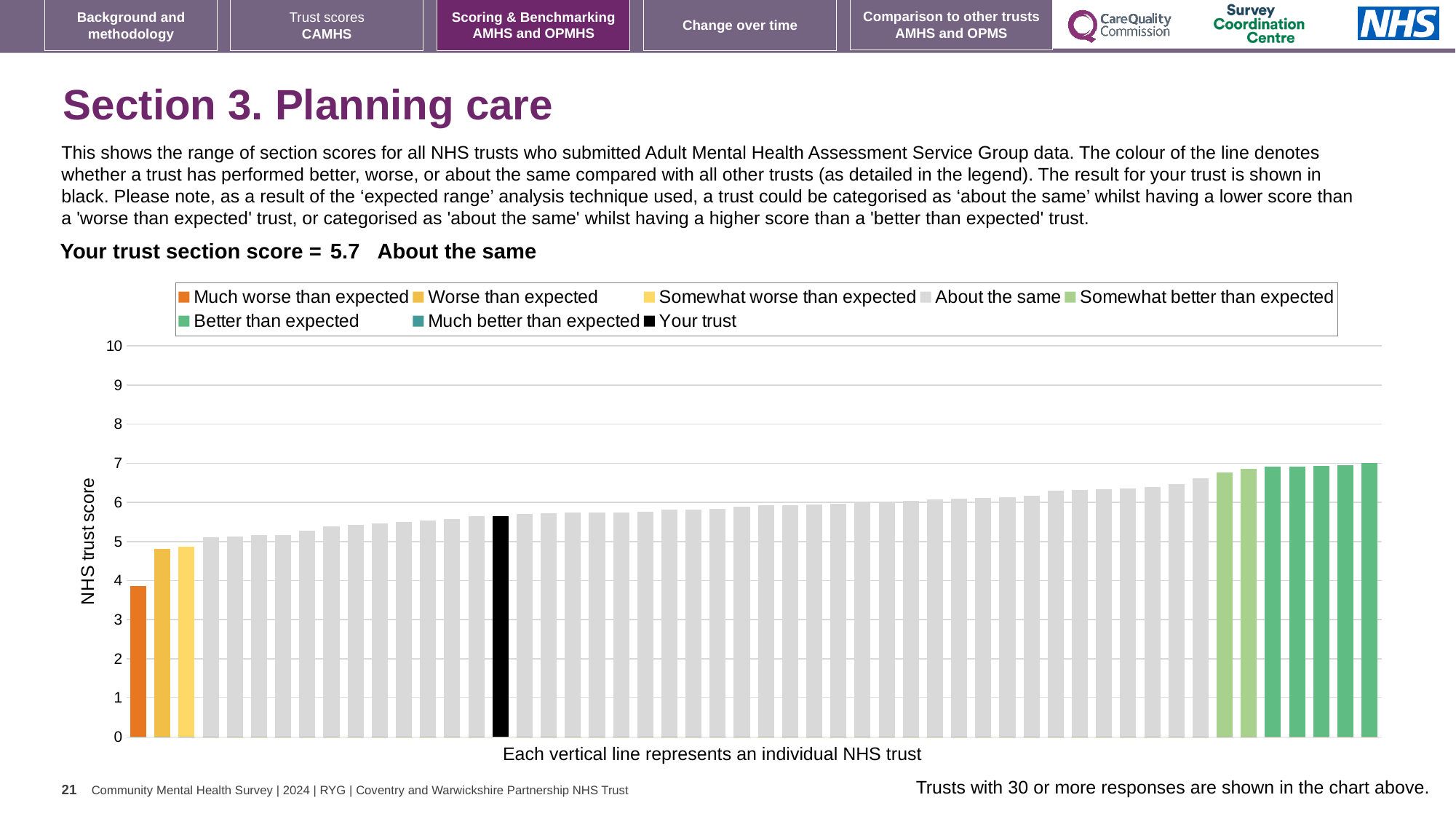
Which category is your trust placed in according to the slide? About the same What colour is used for the 'Your trust' bar in the chart? black How many entries does the chart legend list? 8 How many bars are coloured as 'Better than expected' (dark green)? 5 Is the value for the lowest (orange) bar greater or less than 5? less What is the label on the vertical axis of the chart? NHS trust score Which legend category does the lowest bar in the chart belong to? Much worse than expected What kind of chart is shown on the slide? bar chart Is the value for your trust (black bar) greater or less than 5? greater What is the section score for your trust shown on the slide? 5.7 Do the bar values rise or fall from left to right along the x axis? rise Is the value for the tallest bar greater or less than 8? less